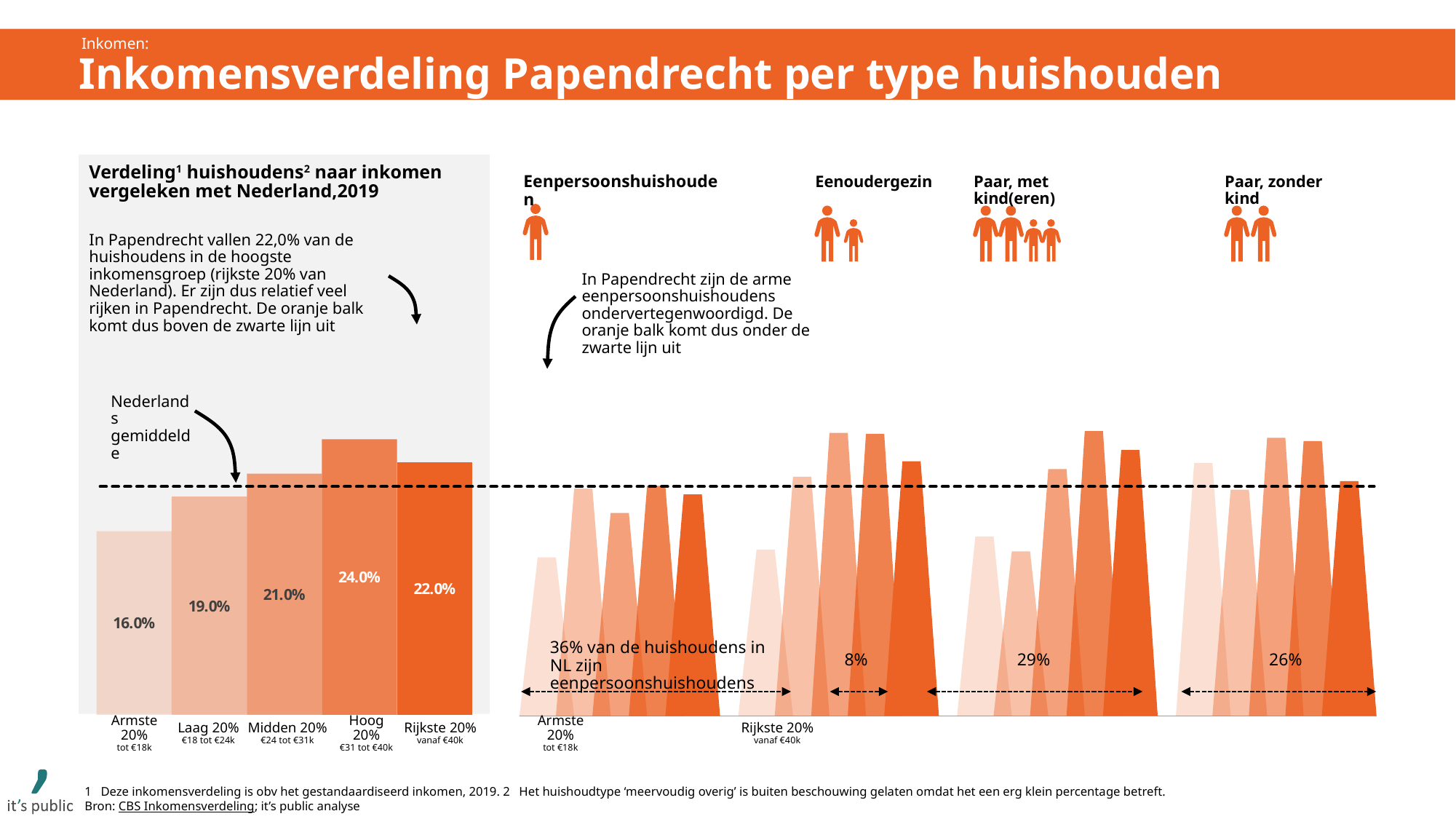
In the left chart 'Verdeling huishoudens naar inkomen vergeleken met Nederland, 2019', what is the difference between the values for Hoog 20% and Rijkste 20%? 2.0 percentage points In the left chart 'Verdeling huishoudens naar inkomen vergeleken met Nederland, 2019', which income group has the highest value? Hoog 20% In the left chart 'Verdeling huishoudens naar inkomen vergeleken met Nederland, 2019', what is the value for Rijkste 20%? 22.0% In the left chart 'Verdeling huishoudens naar inkomen vergeleken met Nederland, 2019', which is larger: the value for Laag 20% or for Midden 20%? Midden 20% In the right-hand charts per household type, which household type has the smallest share of households in NL? Eenoudergezin In the right-hand charts per household type, what percentage of households in NL are eenpersoonshuishoudens? 36% What kind of chart is the left chart 'Verdeling huishoudens naar inkomen vergeleken met Nederland, 2019'? Bar chart In the left chart 'Verdeling huishoudens naar inkomen vergeleken met Nederland, 2019', what is the value for Armste 20%? 16.0% In the left chart 'Verdeling huishoudens naar inkomen vergeleken met Nederland, 2019', what is the value for Midden 20%? 21.0% In the left chart 'Verdeling huishoudens naar inkomen vergeleken met Nederland, 2019', which income group has the lowest value? Armste 20% In the left chart 'Verdeling huishoudens naar inkomen vergeleken met Nederland, 2019', do the values rise or fall from Armste 20% to Hoog 20%? Rise In the left chart 'Verdeling huishoudens naar inkomen vergeleken met Nederland, 2019', how many income groups are shown? 5